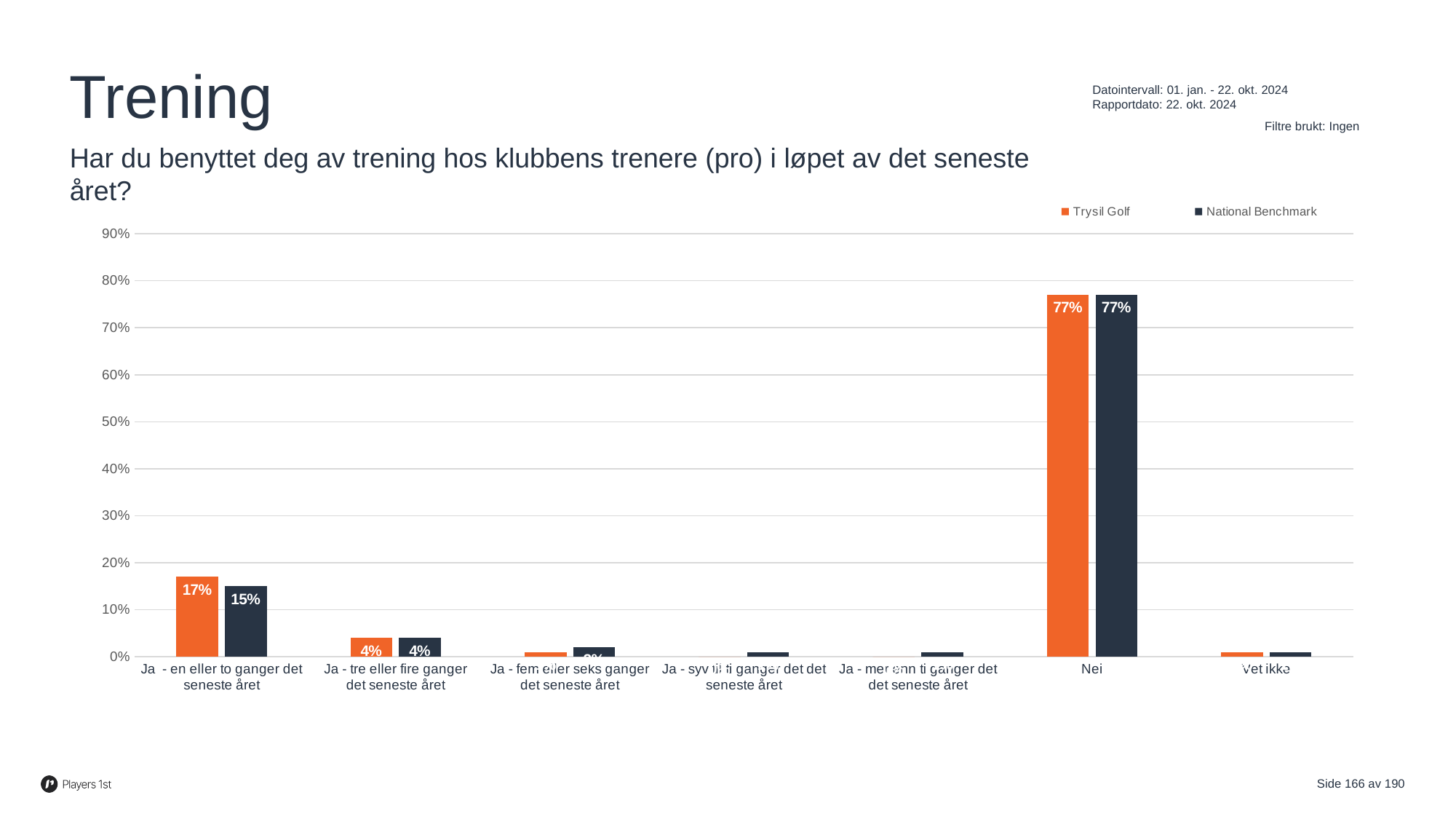
Is the National Benchmark value for "Nei" greater or less than 70%? greater What is the National Benchmark value for "Ja - tre eller fire ganger det seneste året"? 4% What kind of chart is shown on the slide? Bar chart How many categories are shown on the x axis of the chart? 7 What is the difference between the Trysil Golf and National Benchmark values for "Ja - en eller to ganger det seneste året"? 2 percentage points For "Ja - en eller to ganger det seneste året", which series has the larger value, Trysil Golf or National Benchmark? Trysil Golf Is the Trysil Golf value for "Ja - tre eller fire ganger det seneste året" greater or less than 10%? less What is the Trysil Golf value for "Ja - en eller to ganger det seneste året"? 17% What is the National Benchmark value for "Ja - en eller to ganger det seneste året"? 15% How many series does the legend list? 2 What is the Trysil Golf value for "Nei"? 77% Which category has the highest Trysil Golf value? Nei